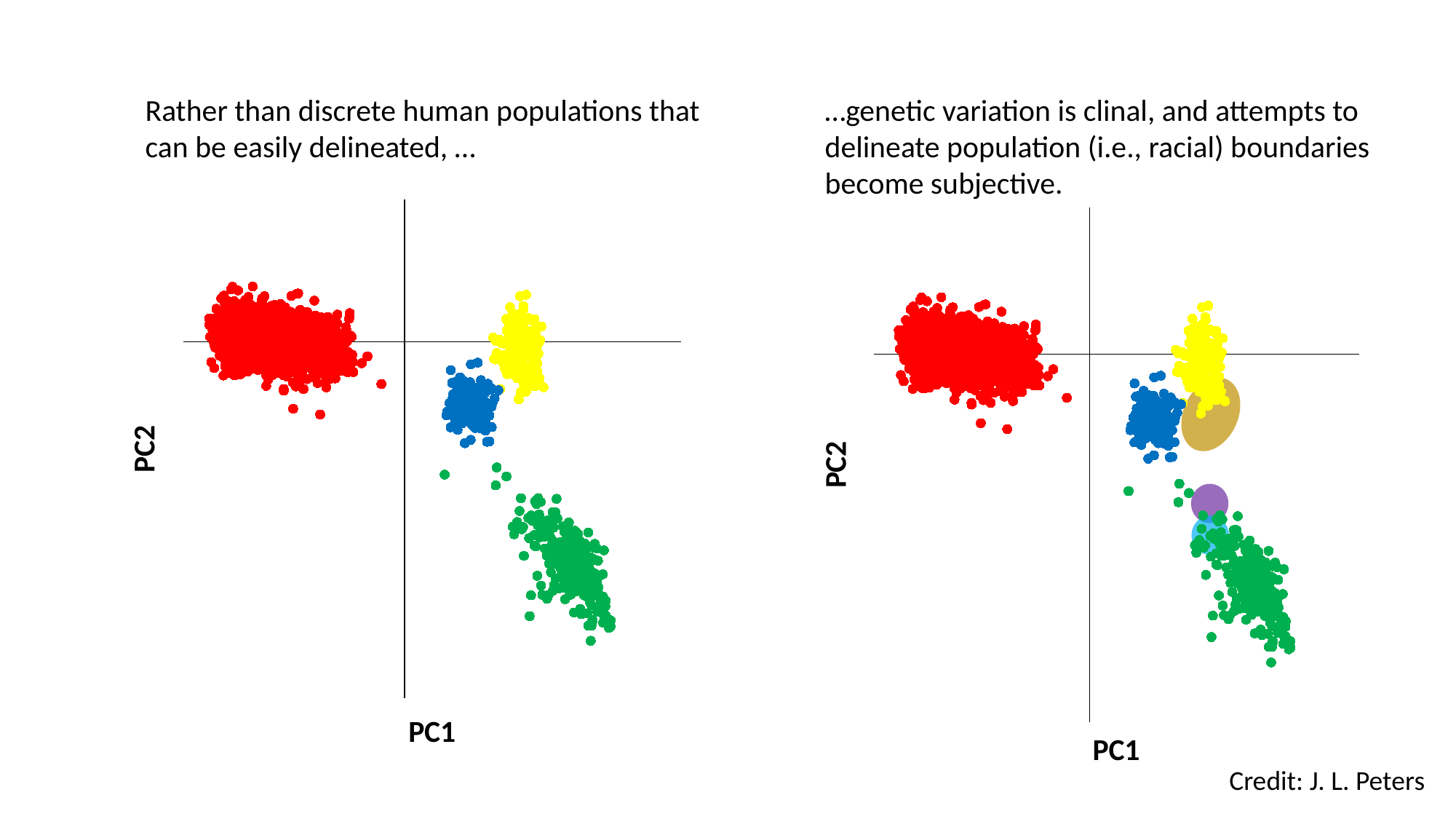
On the left chart, which coloured cluster lies furthest to the right along the PC1 axis? green On the right chart, is the red cluster to the left or to the right of the vertical PC2 axis line? left What kind of chart is the right chart on the slide? scatter plot On the right chart, is the green cluster above or below the horizontal PC1 axis line? below On the left chart, which cluster is positioned higher along PC2, the blue cluster or the green cluster? blue What kind of chart is the left chart on the slide? scatter plot On the left chart, which coloured cluster lies lowest along the PC2 axis? green On the left chart, what is the label of the horizontal axis? PC1 On the left chart, how many differently coloured clusters of points are plotted? 4 On the right chart, what is the label of the vertical axis? PC2 On the left chart, which coloured cluster lies furthest to the left along the PC1 axis? red